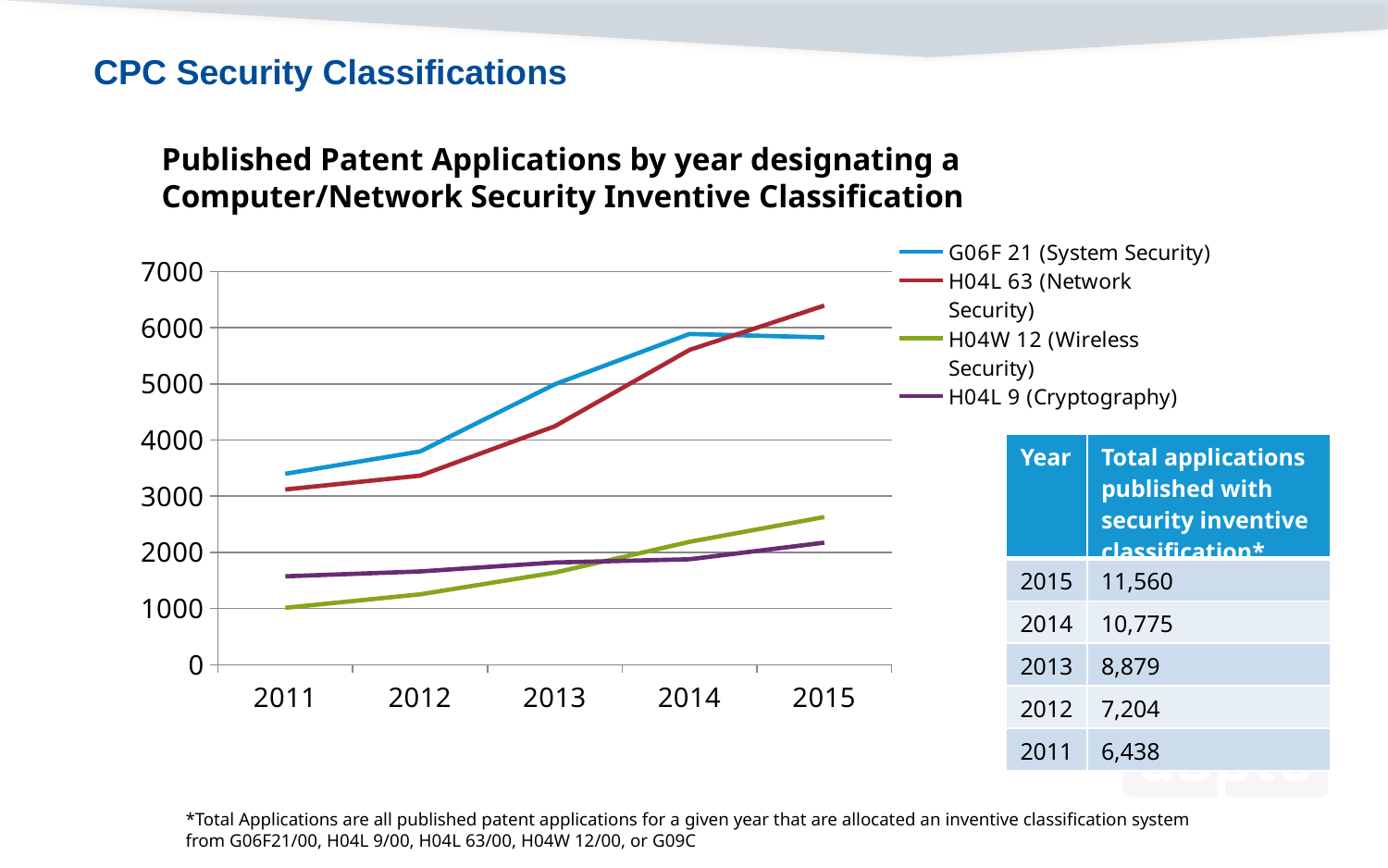
How many series does the chart legend list? 4 What type of chart is shown on the slide? Line chart Which series has the lowest value in 2011? H04W 12 (Wireless Security) Does the H04L 63 (Network Security) series rise or fall from 2011 to 2015? rise Which series is drawn with the green line in the chart? H04W 12 (Wireless Security) Which series has the highest value in 2015? H04L 63 (Network Security) How many years are plotted along the x axis of the chart? 5 Is the value for H04L 63 (Network Security) in 2015 greater or less than 6000? greater Is the value for H04W 12 (Wireless Security) in 2015 greater or less than 3000? less Is the value for G06F 21 (System Security) in 2011 greater or less than 3000? greater In 2012, which is larger: H04W 12 (Wireless Security) or H04L 9 (Cryptography)? H04L 9 (Cryptography)